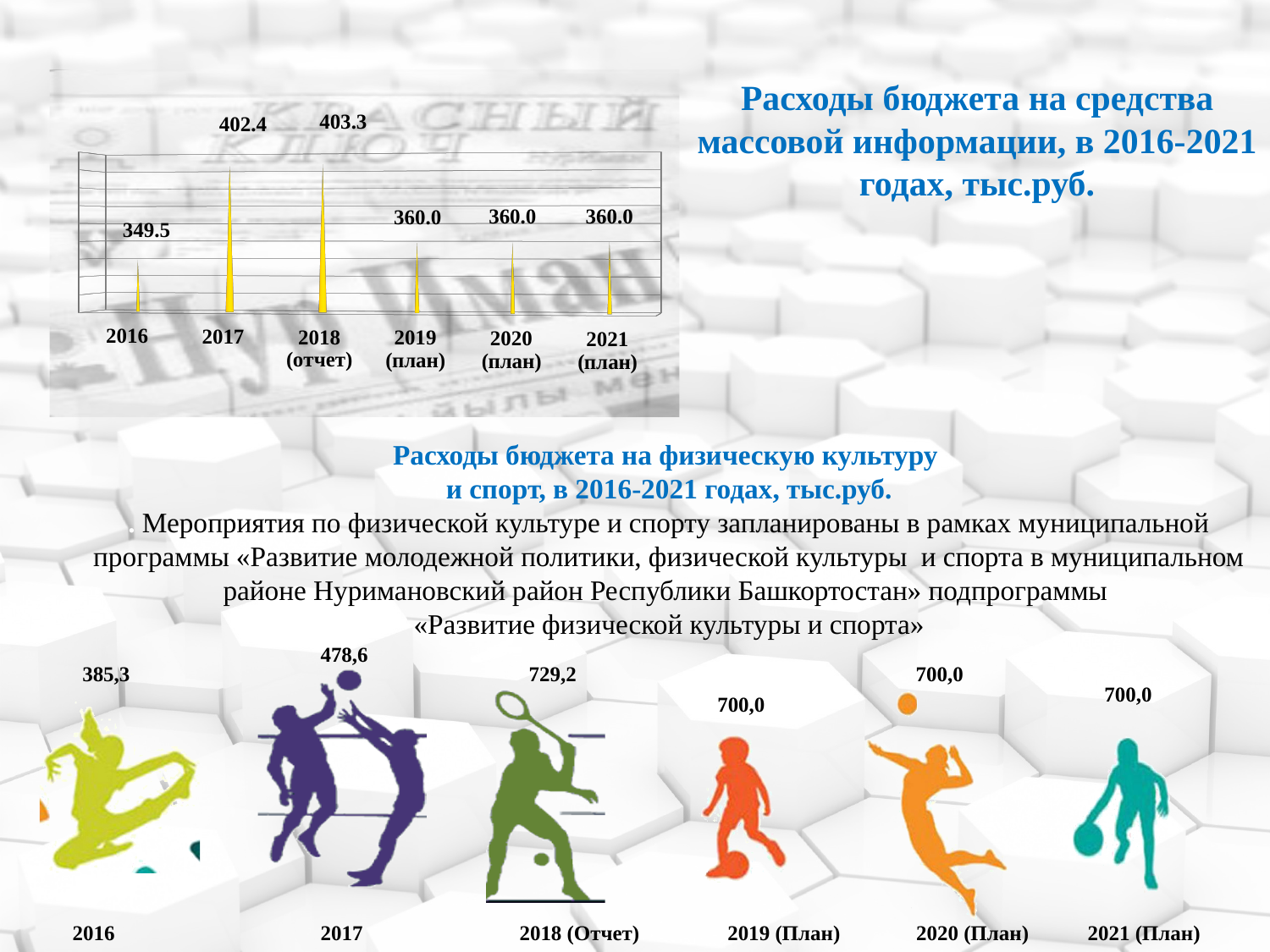
What kind of chart is 'Расходы бюджета на средства массовой информации, в 2016-2021 годах, тыс.руб.'? bar chart In the chart 'Расходы бюджета на средства массовой информации, в 2016-2021 годах, тыс.руб.', what is the value for 2016? 349.5 In the infographic 'Расходы бюджета на физическую культуру и спорт', what is the difference between the 2018 (Отчет) value and the 2017 value? 250,6 In the chart 'Расходы бюджета на средства массовой информации', which year has the lowest value? 2016 In the chart 'Расходы бюджета на средства массовой информации', what is the value for 2018 (отчет)? 403.3 How many years (categories) are shown in the chart 'Расходы бюджета на средства массовой информации'? 6 In the chart 'Расходы бюджета на средства массовой информации', which year has the highest value? 2018 (отчет) In the chart 'Расходы бюджета на средства массовой информации', what is the value for 2020 (план)? 360.0 In the chart 'Расходы бюджета на средства массовой информации', what is the difference between the 2017 value and the 2016 value? 52.9 In the chart 'Расходы бюджета на средства массовой информации', which is larger: the value for 2017 or the value for 2019 (план)? 2017 In the infographic 'Расходы бюджета на физическую культуру и спорт, в 2016-2021 годах, тыс.руб.', which year has the highest value? 2018 (Отчет) In the chart 'Расходы бюджета на средства массовой информации', do the values change or stay the same from 2019 (план) to 2021 (план)? stay the same